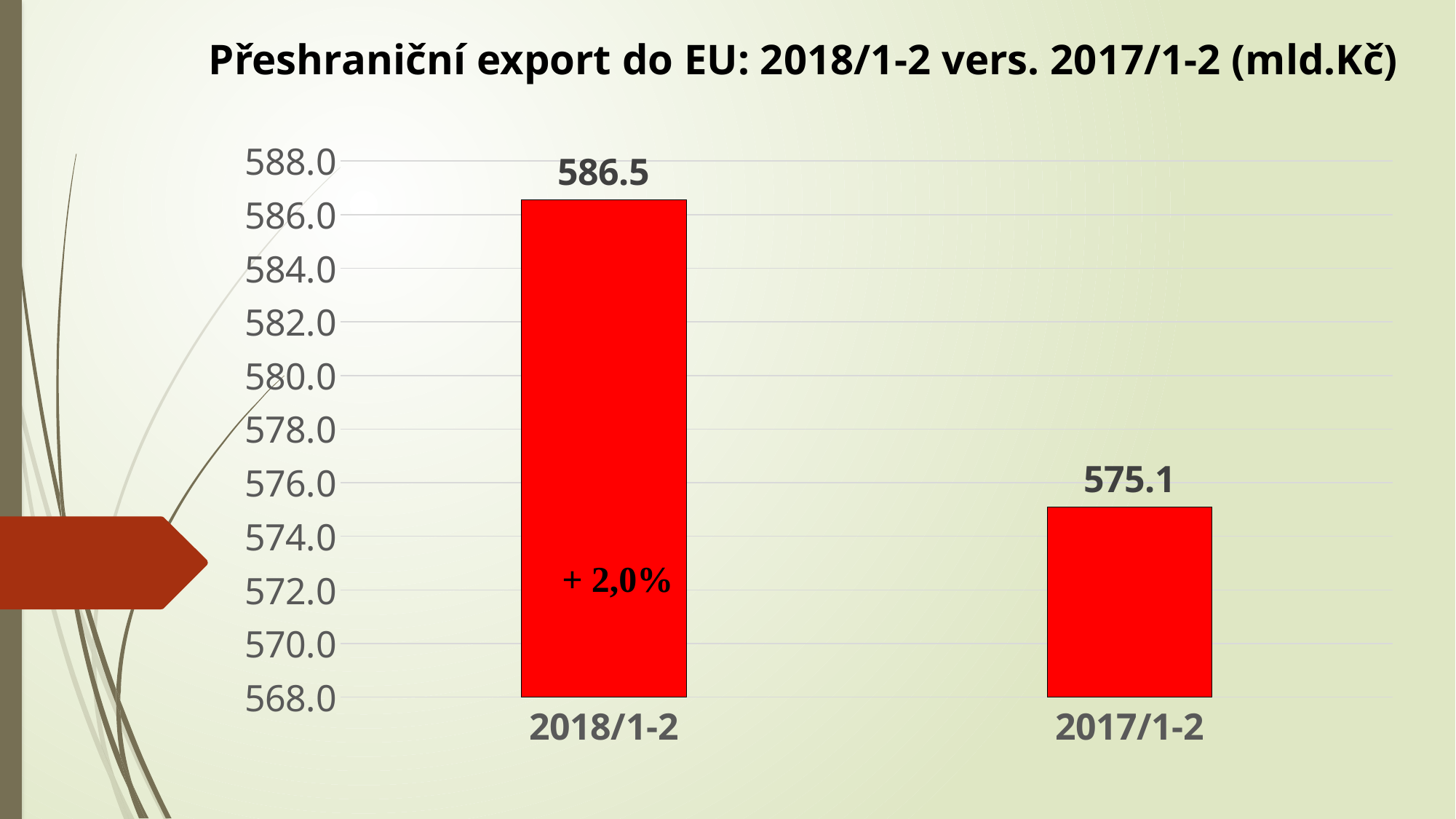
What is the value for 2018/1-2? 586.5 Is the value for 2018/1-2 greater or less than 584.0? greater How many categories are shown in the chart? 2 What kind of chart is shown on the slide? bar chart What is the value for 2017/1-2? 575.1 Is the value for 2017/1-2 greater or less than 580.0? less Which is larger, the value for 2018/1-2 or the value for 2017/1-2? 2018/1-2 What is the title of the chart? Přeshraniční export do EU: 2018/1-2 vers. 2017/1-2 (mld.Kč) Which category has the lowest value? 2017/1-2 What is the difference between the values for 2018/1-2 and 2017/1-2? 11.4 Which category has the highest value? 2018/1-2 What percentage change is printed on the 2018/1-2 bar? + 2,0%